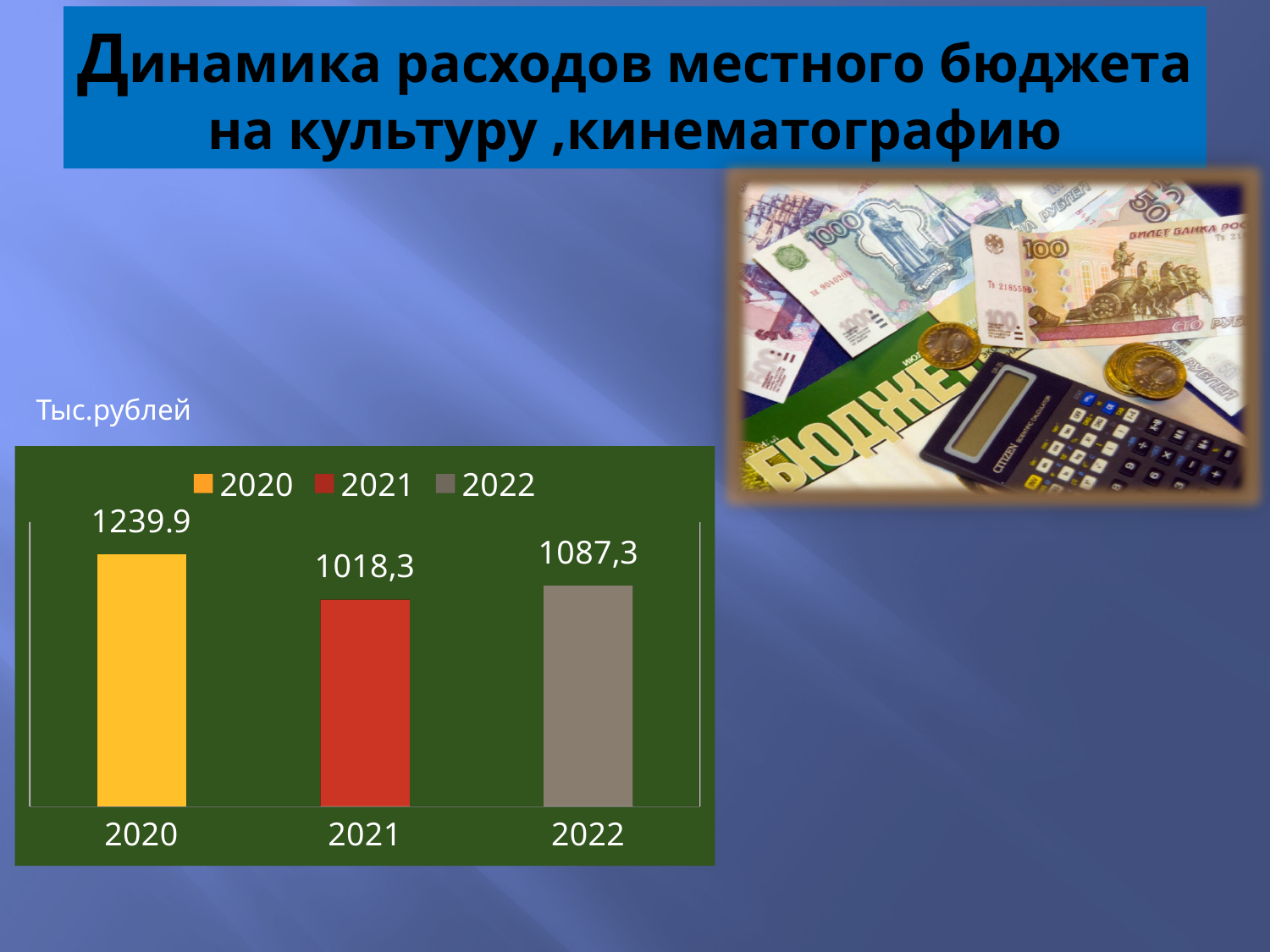
What is the value for 2020? 1239.9 How many bars are shown in the chart? 3 What is the difference between the values for 2022 and 2021? 69 What is the value for 2021? 1018,3 What is the value for 2022? 1087,3 Which year has the highest value? 2020 Does the value rise or fall from 2020 to 2021? fall Which year has the lowest value? 2021 Which is larger, the value for 2020 or the value for 2022? 2020 What unit label is shown above the chart? Тыс.рублей How many entries does the legend list? 3 What kind of chart is shown on the slide? bar chart